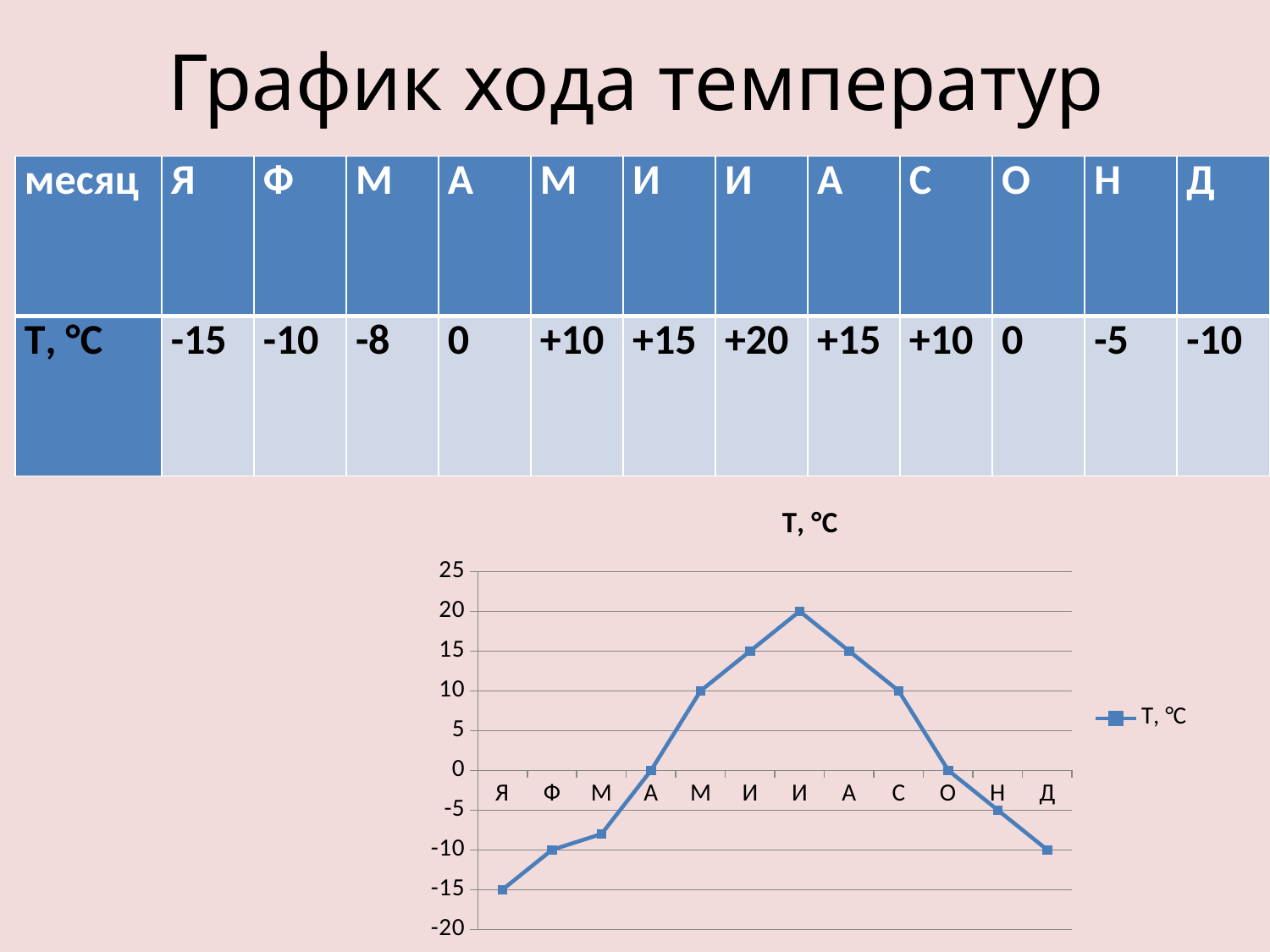
How many months (points) are plotted on the chart? 12 Which month has the highest temperature on the chart? И (July, the seventh month) What is the difference between the highest temperature (+20) and the lowest temperature (-15)? 35 How many series does the chart legend list? 1 What is the title of the chart? Т, °С What is the temperature value for Д (December)? -10 Which month has the lowest temperature on the chart? Я (January) Which is larger, the temperature for Ф (February) or for С (September)? С (September) What kind of chart is shown on the slide? line chart Do the values rise or fall along the x axis from Я to the seventh month И? rise What is the temperature value for Н (November)? -5 What is the temperature value for Я (January)? -15